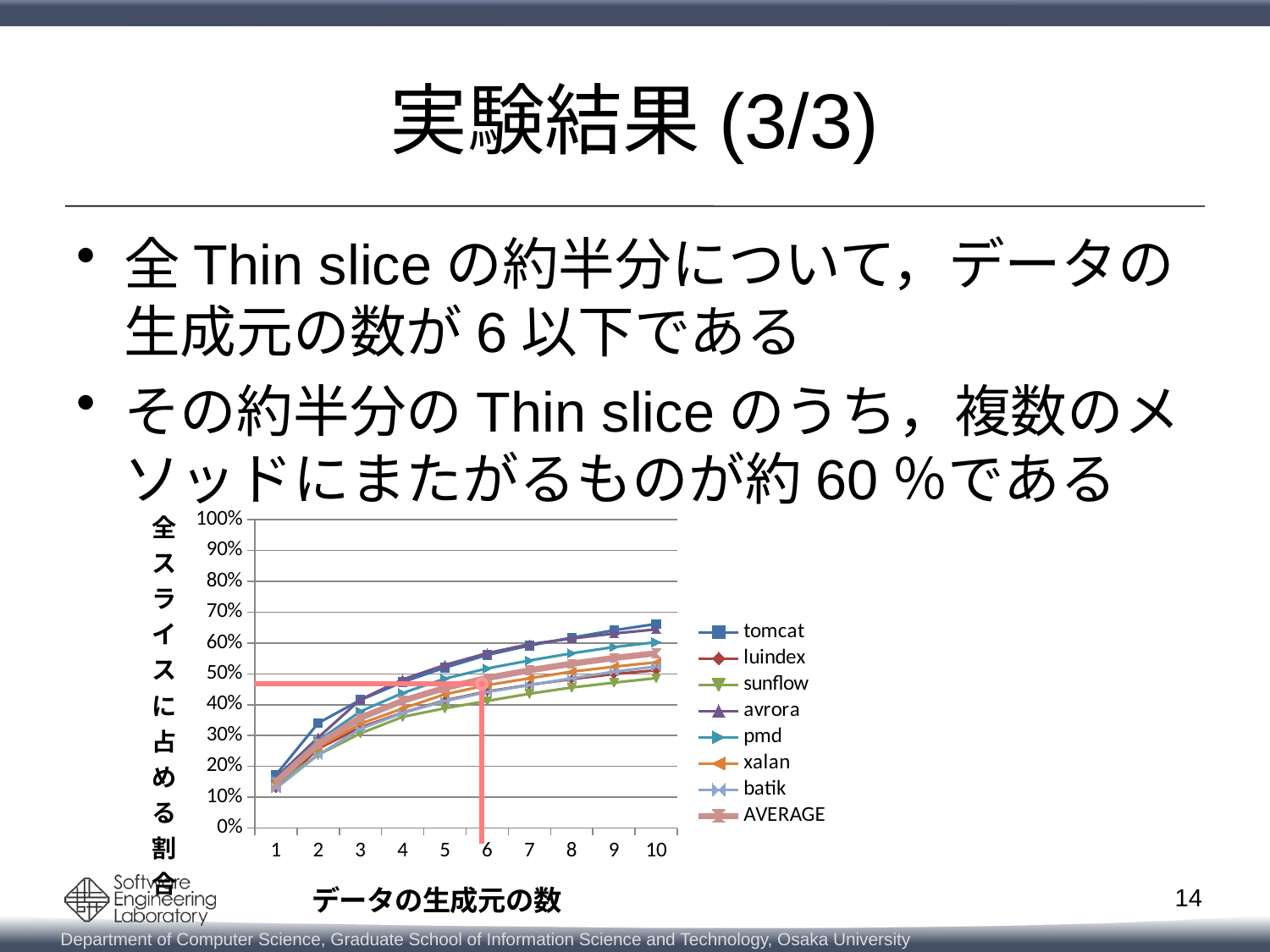
What is the x-axis title of the chart? データの生成元の数 What kind of chart is shown on the slide? line chart Is the value for tomcat at x = 1 greater or less than 20%? less Is the value for sunflow at x = 10 greater or less than 60%? less At x = 10, which is larger, the value for tomcat or the value for sunflow? tomcat Which series has the highest value at x = 10? tomcat Is the value for tomcat at x = 10 greater or less than 60%? greater How many series does the chart's legend list? 8 Which series has the highest value at x = 2? tomcat How many points are there along the x axis of the chart? 10 Which series has the lowest value at x = 10? sunflow Do the values of the tomcat series rise or fall as the number of data sources increases along the x axis? rise